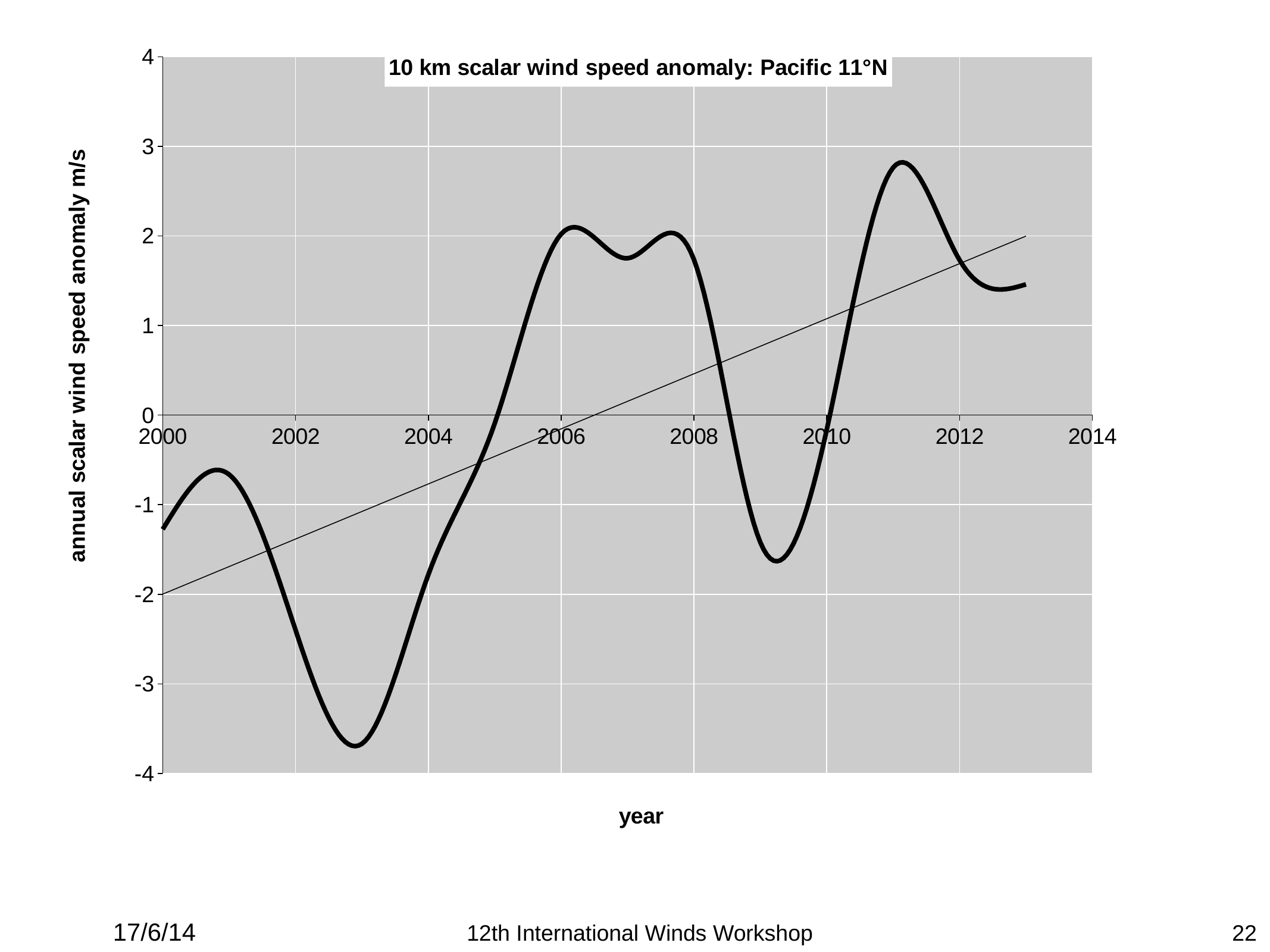
Is the wind speed anomaly for 2009 greater or less than -1? less Does the straight trend line rise or fall from 2000 to 2013? rises Is the wind speed anomaly for 2003 greater or less than -3? less Is the wind speed anomaly for 2001 greater or less than -1? greater In which year does the wind speed anomaly reach its lowest value? 2003 Which year has the larger wind speed anomaly, 2006 or 2011? 2011 What kind of chart is shown on the slide? line chart In which year does the wind speed anomaly reach its highest value? 2011 What is the title of the chart? 10 km scalar wind speed anomaly: Pacific 11°N What is the label of the vertical axis? annual scalar wind speed anomaly m/s